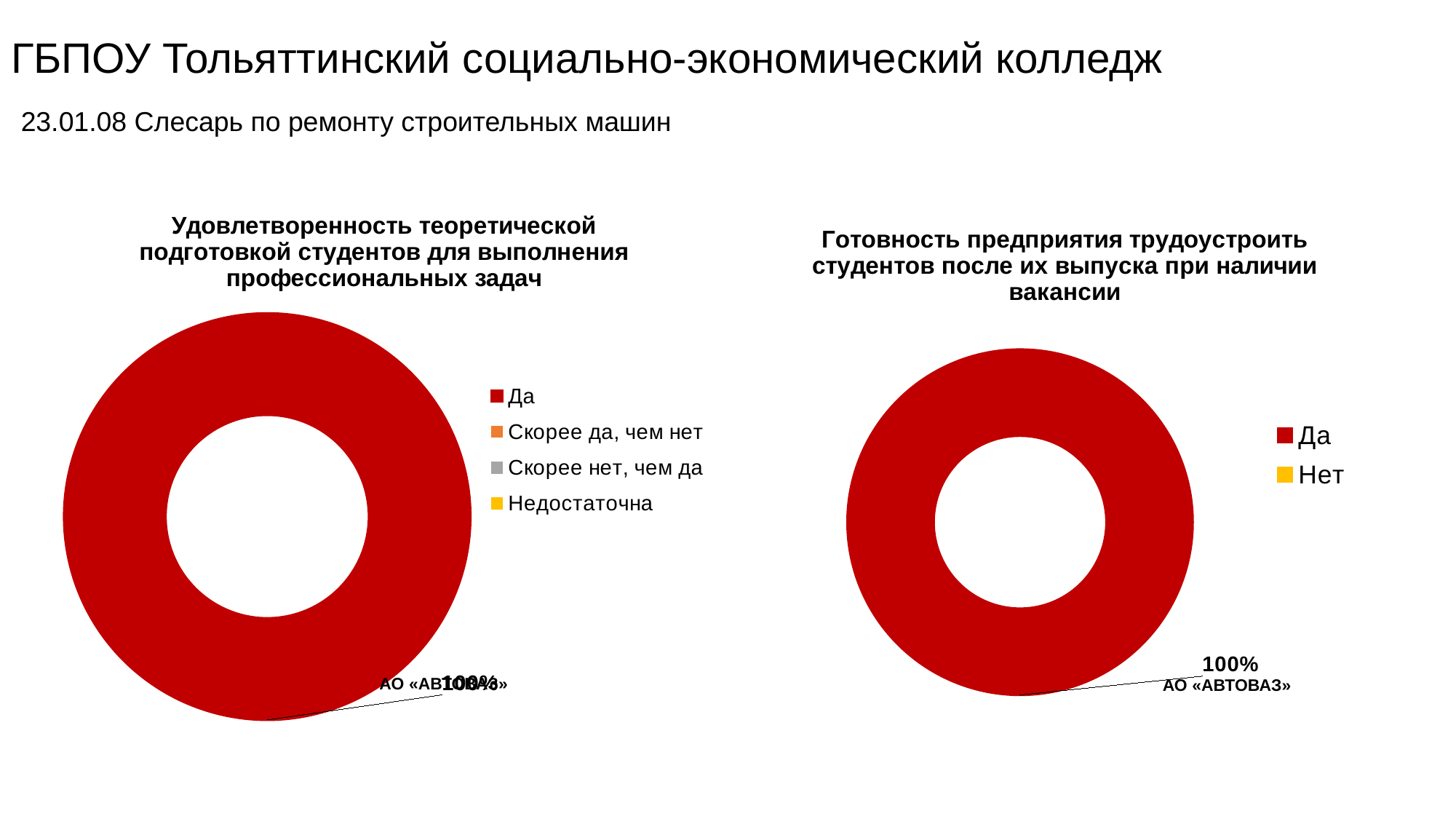
In the left chart, which legend category accounts for the whole doughnut? Да In the left chart, what colour is the "Да" legend entry? red In the left chart, what share of the doughnut does the "Да" slice take? 100% In the right chart, what share of the doughnut does the "Да" slice take? 100% In the right chart, what organisation name is printed next to the data label? АО «АВТОВАЗ» In the right chart, how many entries does the legend list? 2 In the right chart, which legend category accounts for the whole doughnut? Да In the left chart, how many entries does the legend list? 4 In the right chart, what value is printed on the data label? 100% In the right chart, which of the two legend categories, "Да" or "Нет", has the larger share? Да What kind of chart is the right chart, titled "Готовность предприятия трудоустроить студентов после их выпуска при наличии вакансии"? doughnut chart What kind of chart is the left chart, titled "Удовлетворенность теоретической подготовкой студентов для выполнения профессиональных задач"? doughnut chart